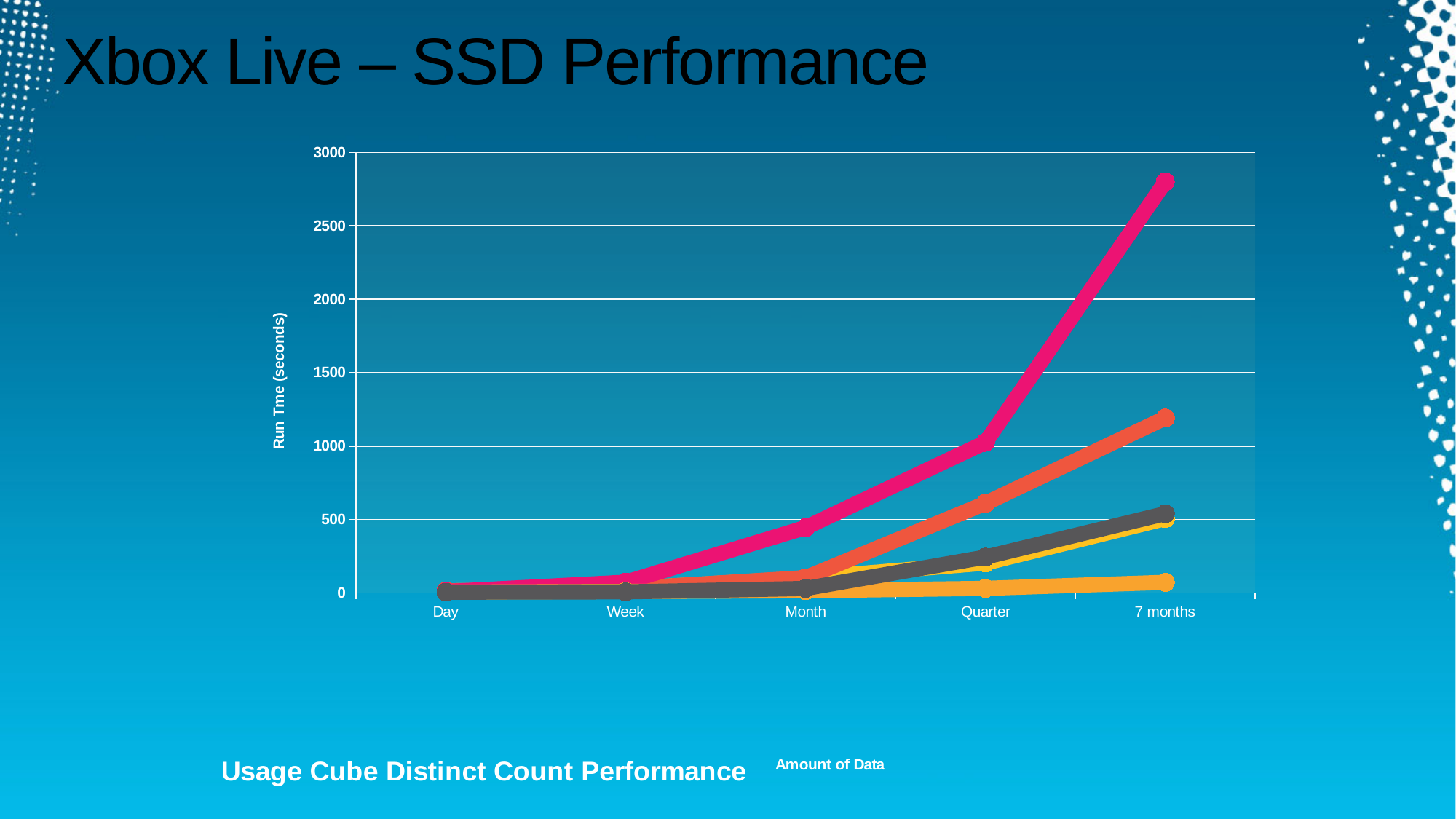
At 7 months, which line has the higher value, the pink line or the red-orange line? pink line Do the values of the pink line rise or fall from Day to 7 months? rise How many categories are shown on the x axis of the chart? 5 How many lines are plotted on the chart? 5 What kind of chart is shown on the slide? line chart Is the value of the pink line at 7 months greater or less than 2500? greater What is the label of the y axis? Run Time (seconds) Is the value of the red-orange line at 7 months greater or less than 1000? greater Is the value of the pink line at Month greater or less than 500? less What is the label of the x axis? Amount of Data At which category does the pink line reach its highest value? 7 months